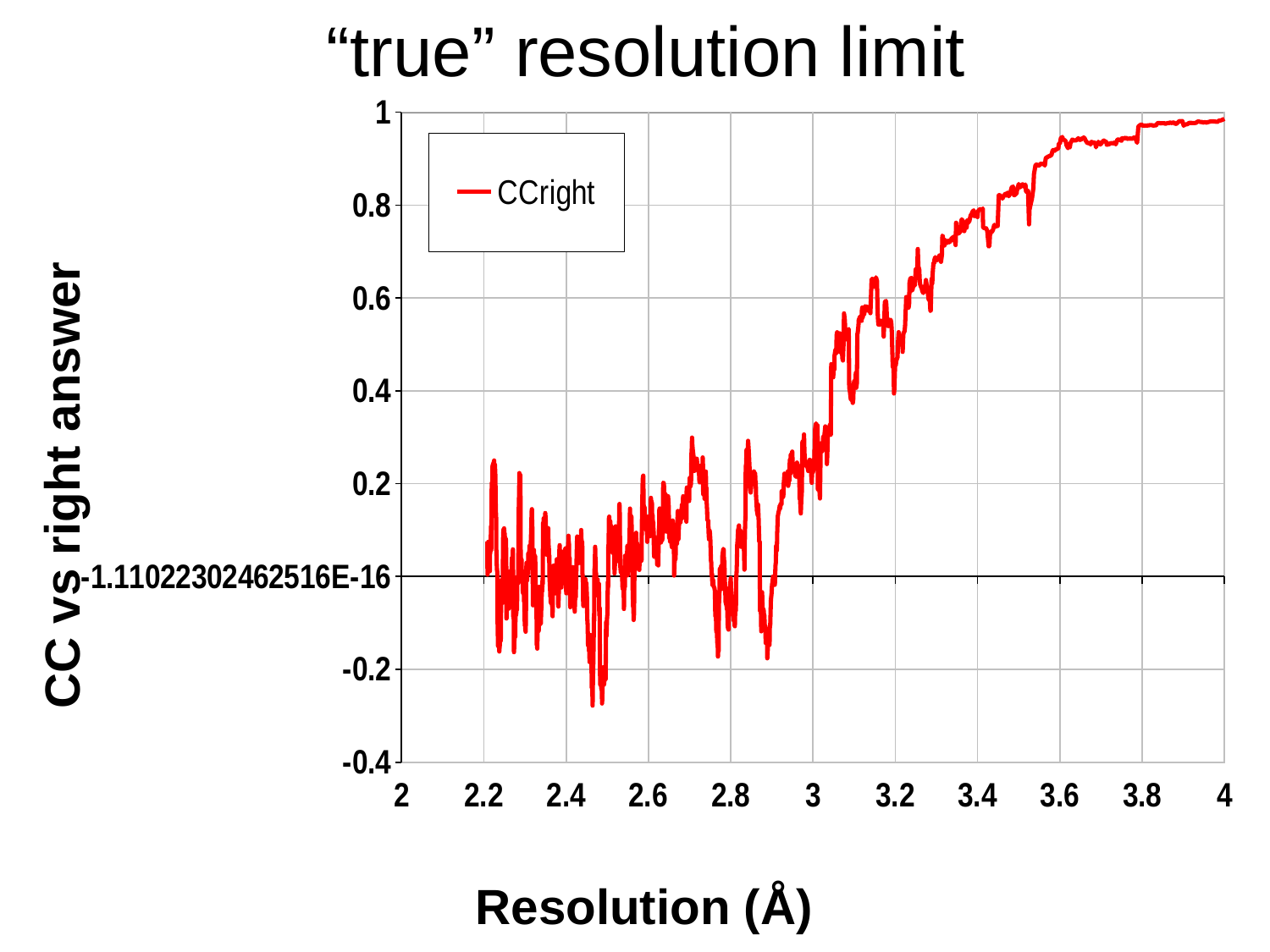
Overall, does the CCright value rise or fall as Resolution increases from 2.2 to 4 Å? rise Is the CCright value at a resolution of 2.8 Å greater or less than 0.2? less What is the name of the series shown in the legend? CCright Is the CCright value at a resolution of 3.8 Å greater or less than 0.6? greater Is the CCright value at a resolution of 4 Å greater or less than 0.8? greater Which of the two resolutions, 2.6 Å or 3.4 Å, has the larger CCright value? 3.4 Å How many series does the legend list? 1 What is the label of the x axis? Resolution (Å) What kind of chart is shown on the slide? line chart